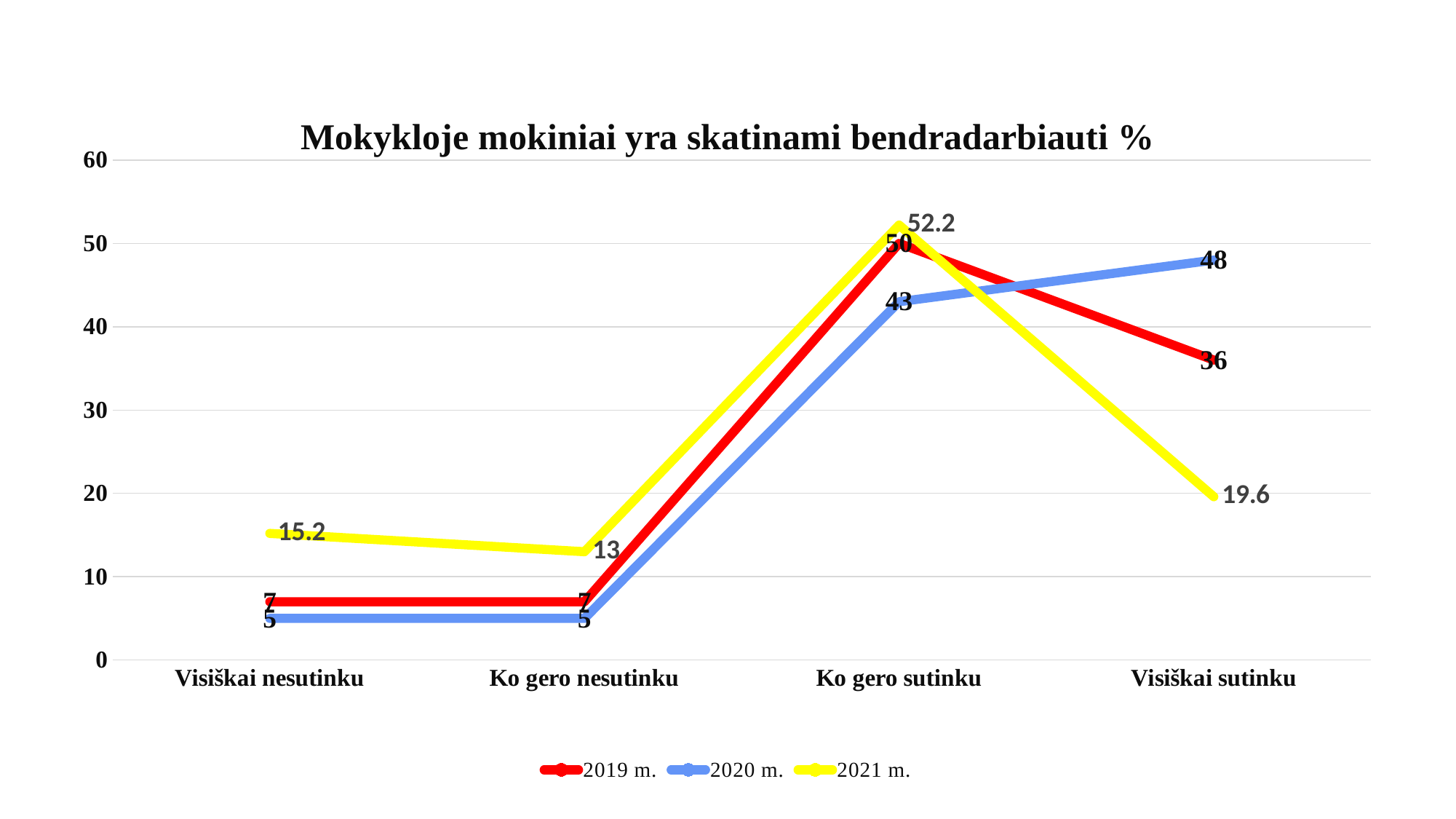
Which category has the lowest value for the 2021 m. series? Ko gero nesutinku What is the value for 2021 m. at Visiškai nesutinku? 15.2 How many categories are shown on the x axis? 4 Which category has the highest value for the 2020 m. series? Visiškai sutinku At Visiškai sutinku, which series has the larger value, 2019 m. or 2020 m.? 2020 m. What kind of chart is shown on the slide? line chart What is the value for 2021 m. at Ko gero sutinku? 52.2 What is the value for 2019 m. at Visiškai sutinku? 36 What is the value for 2020 m. at Visiškai sutinku? 48 How many series does the legend list? 3 What is the difference between the 2021 m. and 2020 m. values at Ko gero sutinku? 9.2 What is the title of the chart? Mokykloje mokiniai yra skatinami bendradarbiauti %